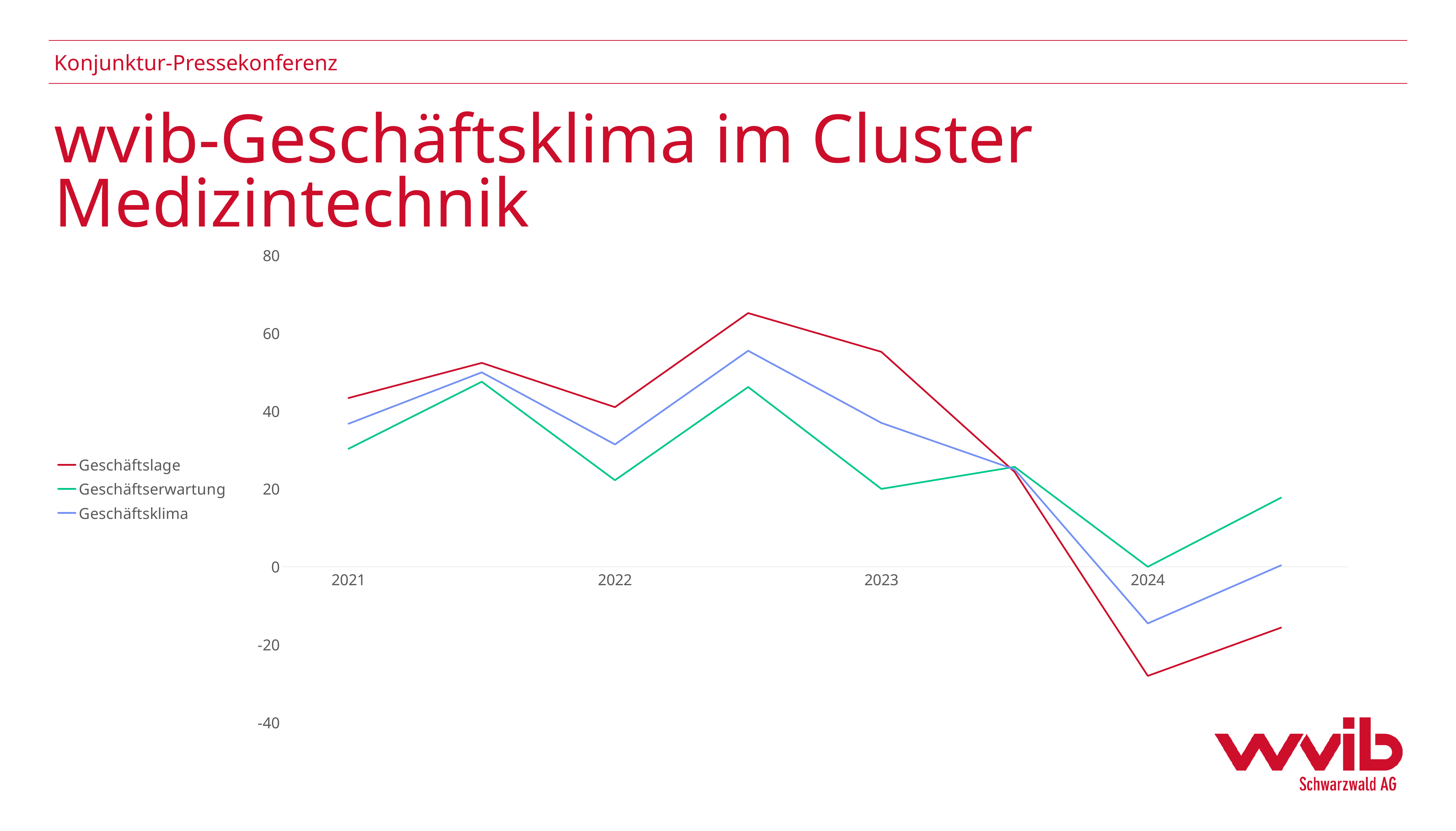
Is the value for Geschäftsklima at 2023 greater or less than 20? greater Is the value for Geschäftslage at 2023 greater or less than 40? greater What kind of chart is shown on the slide? line chart How many series does the legend list? 3 Does the Geschäftslage line rise or fall from 2023 to 2024? fall At 2022, which is larger: Geschäftslage or Geschäftserwartung? Geschäftslage Is the value for Geschäftslage at 2024 greater or less than -20? less How many year labels are shown on the x axis? 4 Which series has the lowest value at 2024? Geschäftslage Which series has the highest value at 2023? Geschäftslage Which series is shown in red in the legend? Geschäftslage